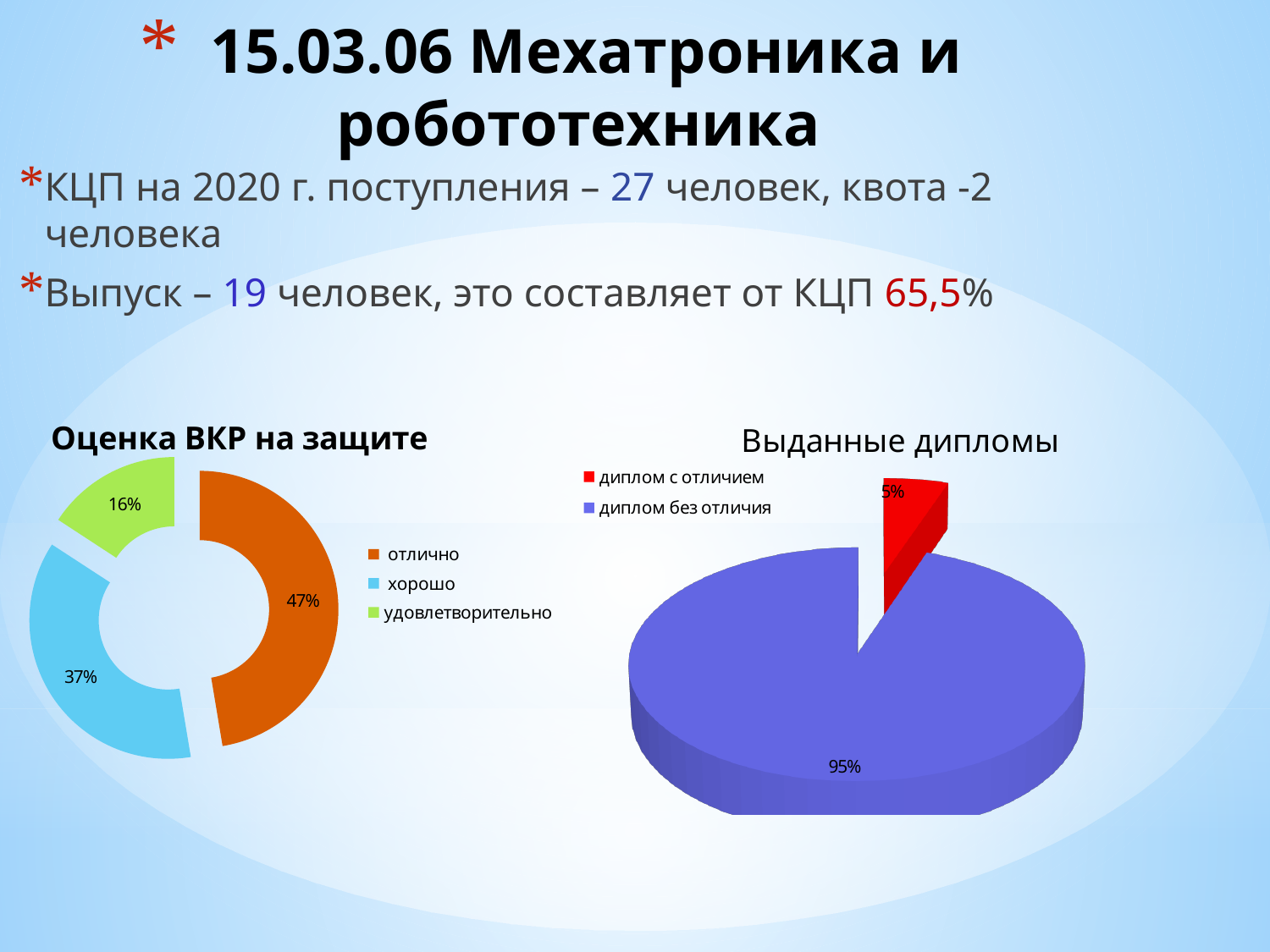
In the chart titled "Выданные дипломы", which category is larger: "диплом с отличием" or "диплом без отличия"? диплом без отличия In the chart titled "Оценка ВКР на защите", what is the share for "отлично"? 47% In the chart titled "Оценка ВКР на защите", which category has the largest share? отлично In the chart titled "Выданные дипломы", what colour is the slice for "диплом с отличием"? red In the chart titled "Оценка ВКР на защите", what is the difference in percentage points between "отлично" and "хорошо"? 10 In the chart titled "Оценка ВКР на защите", what is the share for "хорошо"? 37% In the chart titled "Оценка ВКР на защите", how many categories does the legend list? 3 What kind of chart is the chart titled "Выданные дипломы"? pie chart In the chart titled "Оценка ВКР на защите", what is the share for "удовлетворительно"? 16% In the chart titled "Выданные дипломы", what is the share for "диплом с отличием"? 5% In the chart titled "Выданные дипломы", what is the share for "диплом без отличия"? 95% In the chart titled "Оценка ВКР на защите", which category has the smallest share? удовлетворительно